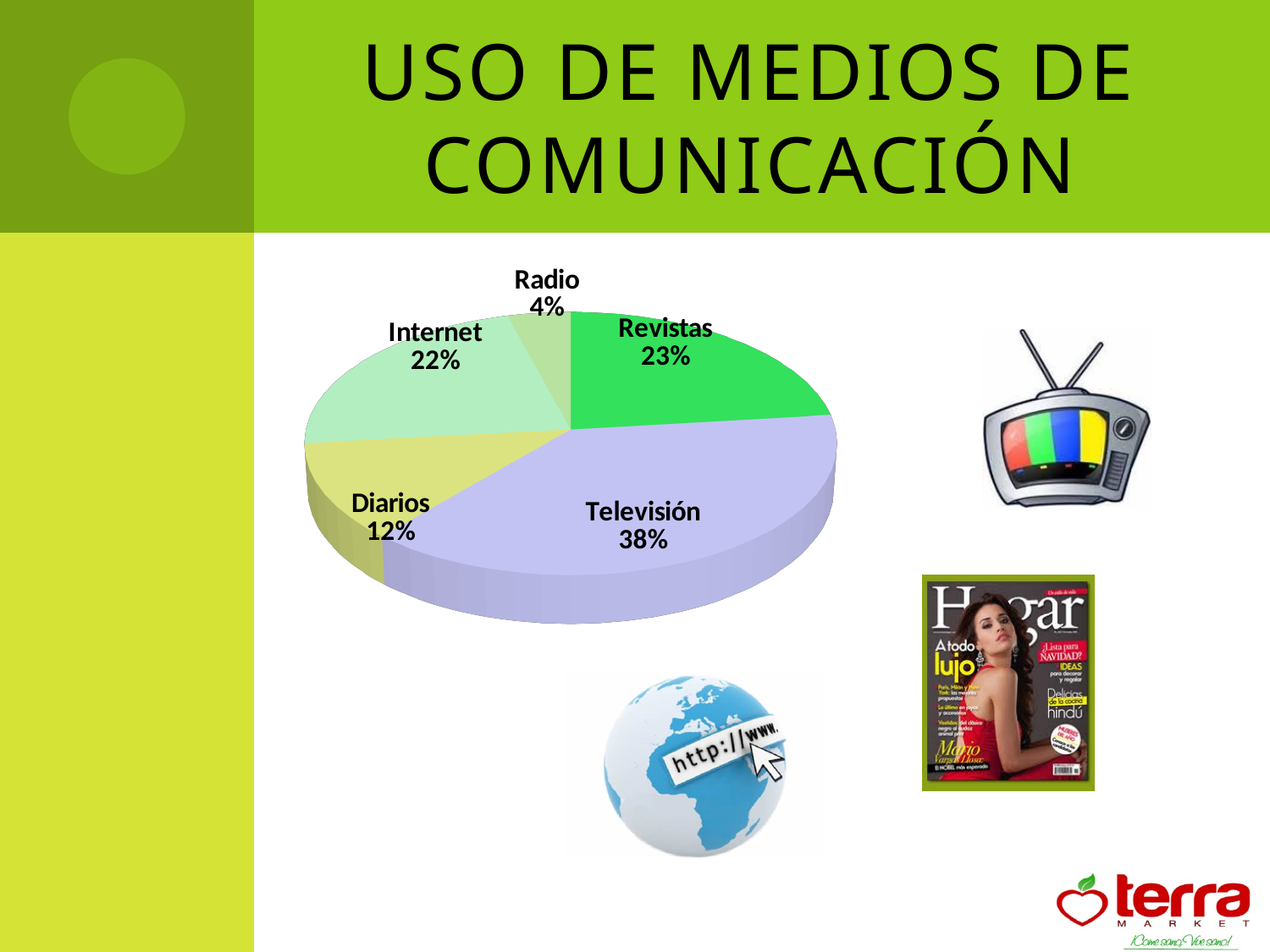
How many categories are shown in the pie chart? 5 Which category has the smallest share of the pie? Radio What is the combined share of Revistas and Internet? 45% What percentage does the Radio slice represent? 4% What is the difference in percentage points between Televisión and Revistas? 15 What type of chart is shown on the slide? pie chart Which is larger, the share for Internet or the share for Diarios? Internet What percentage does the Internet slice represent? 22% Which category has the largest share of the pie? Televisión What is the title of the slide containing the chart? USO DE MEDIOS DE COMUNICACIÓN What percentage does the Diarios slice represent? 12% What percentage does the Televisión slice represent? 38%